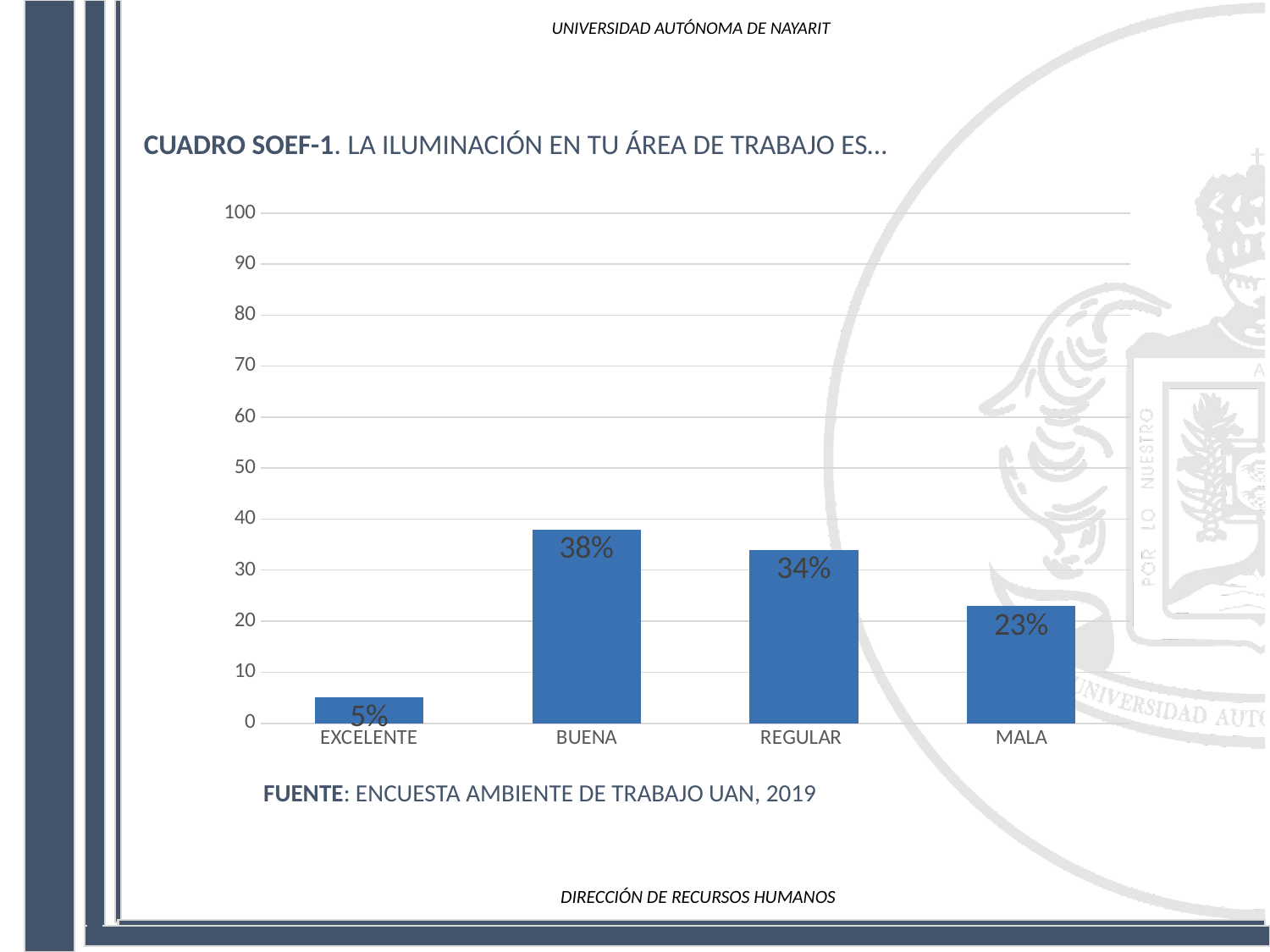
Which category has the lowest value? EXCELENTE Is the value for REGULAR greater or less than 30? greater What is the value for MALA? 23% What is the value for EXCELENTE? 5% What is the difference between the values for BUENA and REGULAR? 4% Which is larger, the value for MALA or the value for EXCELENTE? MALA Which category has the highest value? BUENA What is the value for BUENA? 38% How many categories are shown on the x axis? 4 What is the value for REGULAR? 34% What kind of chart is shown on the slide? bar chart What is the difference between the values for REGULAR and MALA? 11%